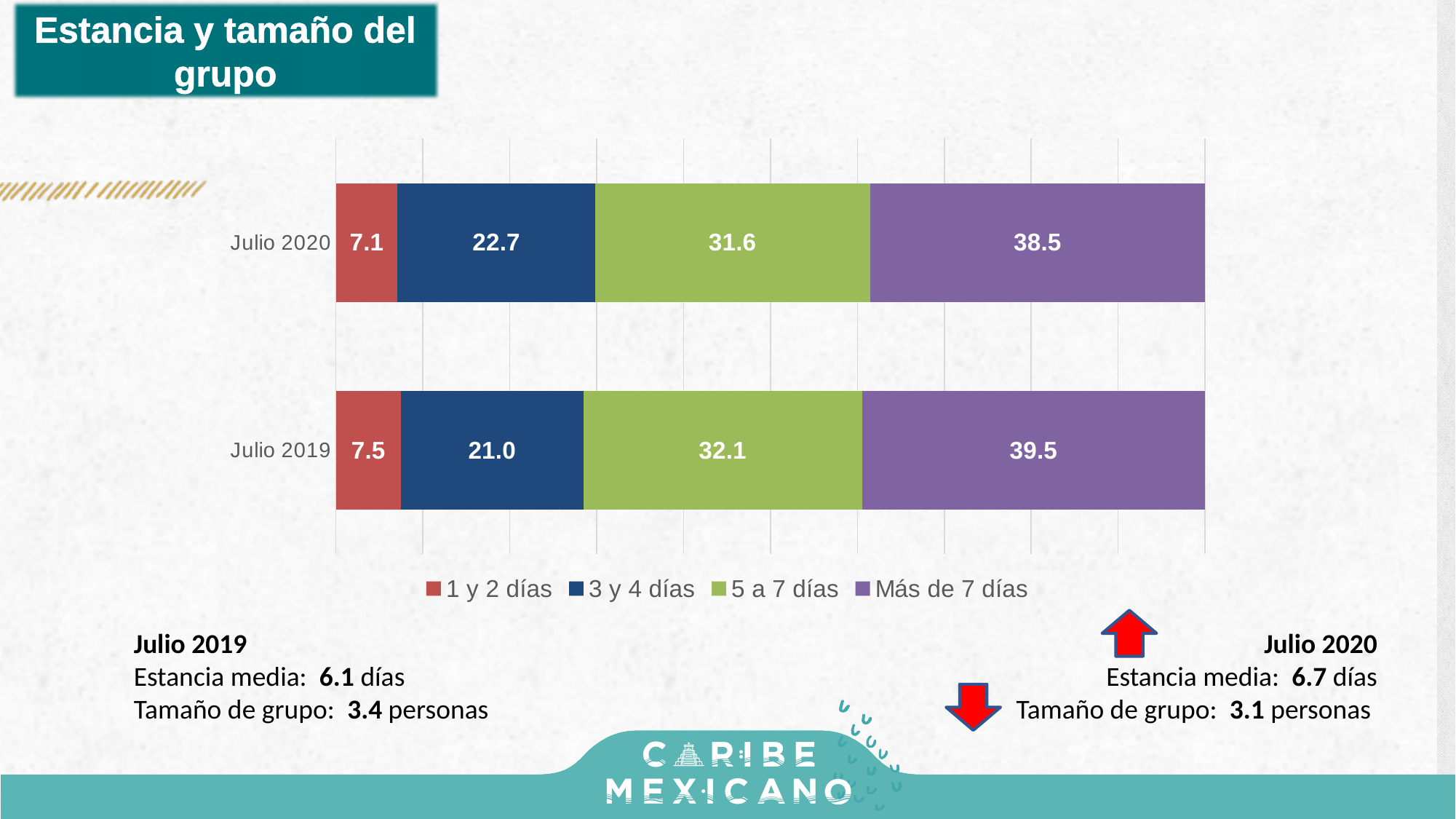
What is the value for '5 a 7 días' in Julio 2020? 31.6 How many series does the legend list? 4 Which is larger: the '5 a 7 días' value for Julio 2019 or for Julio 2020? Julio 2019 How many bars (categories) are shown in the chart? 2 What is the difference between the '3 y 4 días' values for Julio 2020 and Julio 2019? 1.7 Which stay-length segment has the smallest value in the Julio 2019 bar? 1 y 2 días What colour represents the '5 a 7 días' series in the legend? Green Which stay-length segment has the largest value in the Julio 2020 bar? Más de 7 días What is the value for '1 y 2 días' in Julio 2019? 7.5 What is the value for '3 y 4 días' in Julio 2020? 22.7 What is the value for 'Más de 7 días' in Julio 2019? 39.5 What kind of chart is shown on the slide? Stacked bar chart